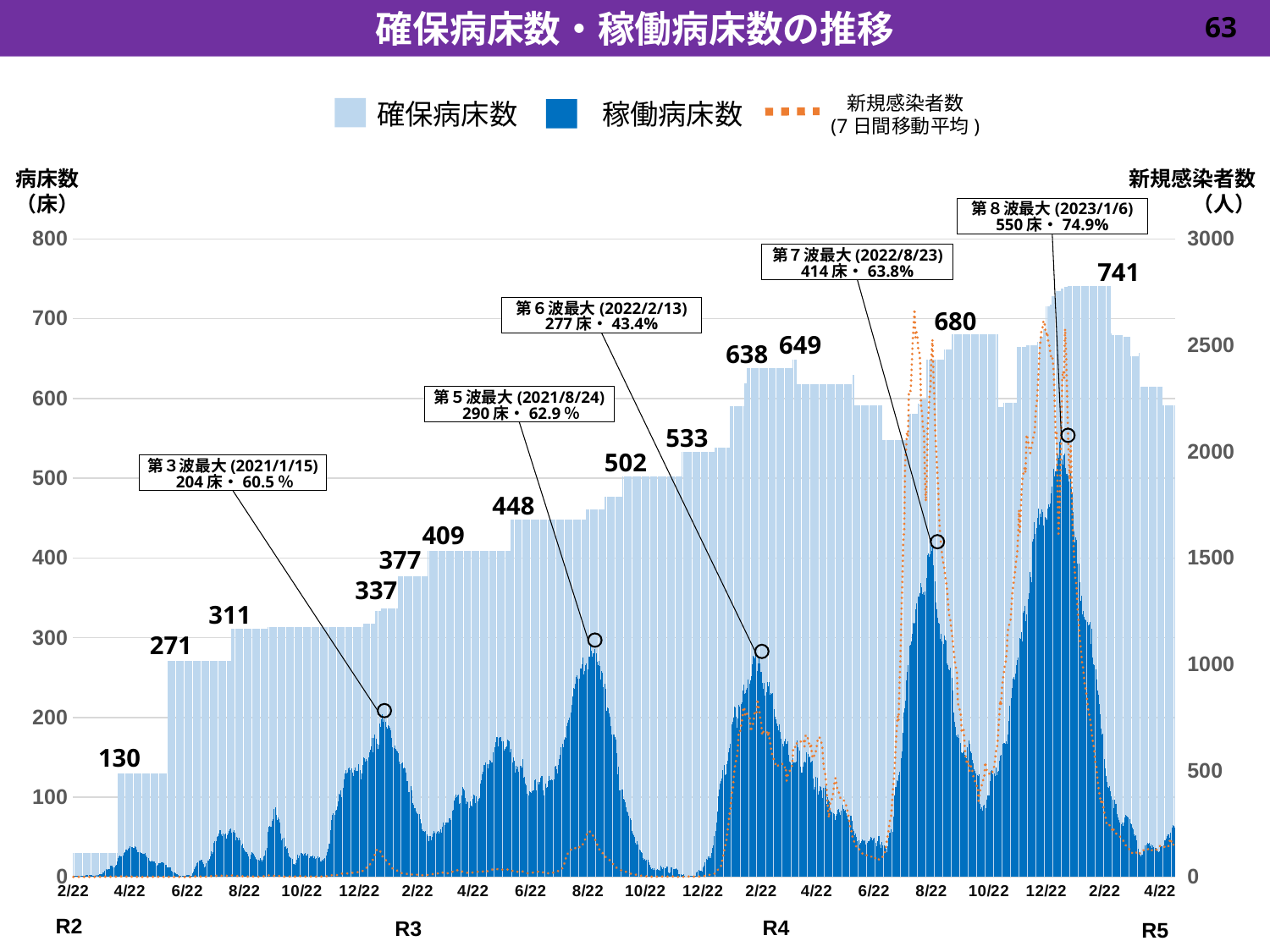
How many series does the legend list? 3 What is the difference between the 確保病床数 labels 741 and 680? 61 What occupancy percentage is shown for the 第7波最大 (2022/8/23) peak? 63.8% What is the highest labelled value of 確保病床数 on the chart? 741 How many 稼働病床 were recorded at the 第8波最大 (2023/1/6) peak? 550床 Is the 稼働病床数 at the 第3波最大 (2021/1/15) peak greater or less than 300? less What kind of chart is used to show 確保病床数 and 稼働病床数? Bar chart What is the difference in 稼働病床数 between the 第8波最大 peak (550床) and the 第7波最大 peak (414床)? 136床 Does the 確保病床数 generally rise or fall from 2/22 of R2 to 2/22 of R5? Rise Which peak had a higher occupancy rate, 第5波最大 (2021/8/24) or 第6波最大 (2022/2/13)? 第5波最大 (2021/8/24) What is the lowest labelled value of 確保病床数 on the chart? 130 What is the title of the chart? 確保病床数・稼働病床数の推移